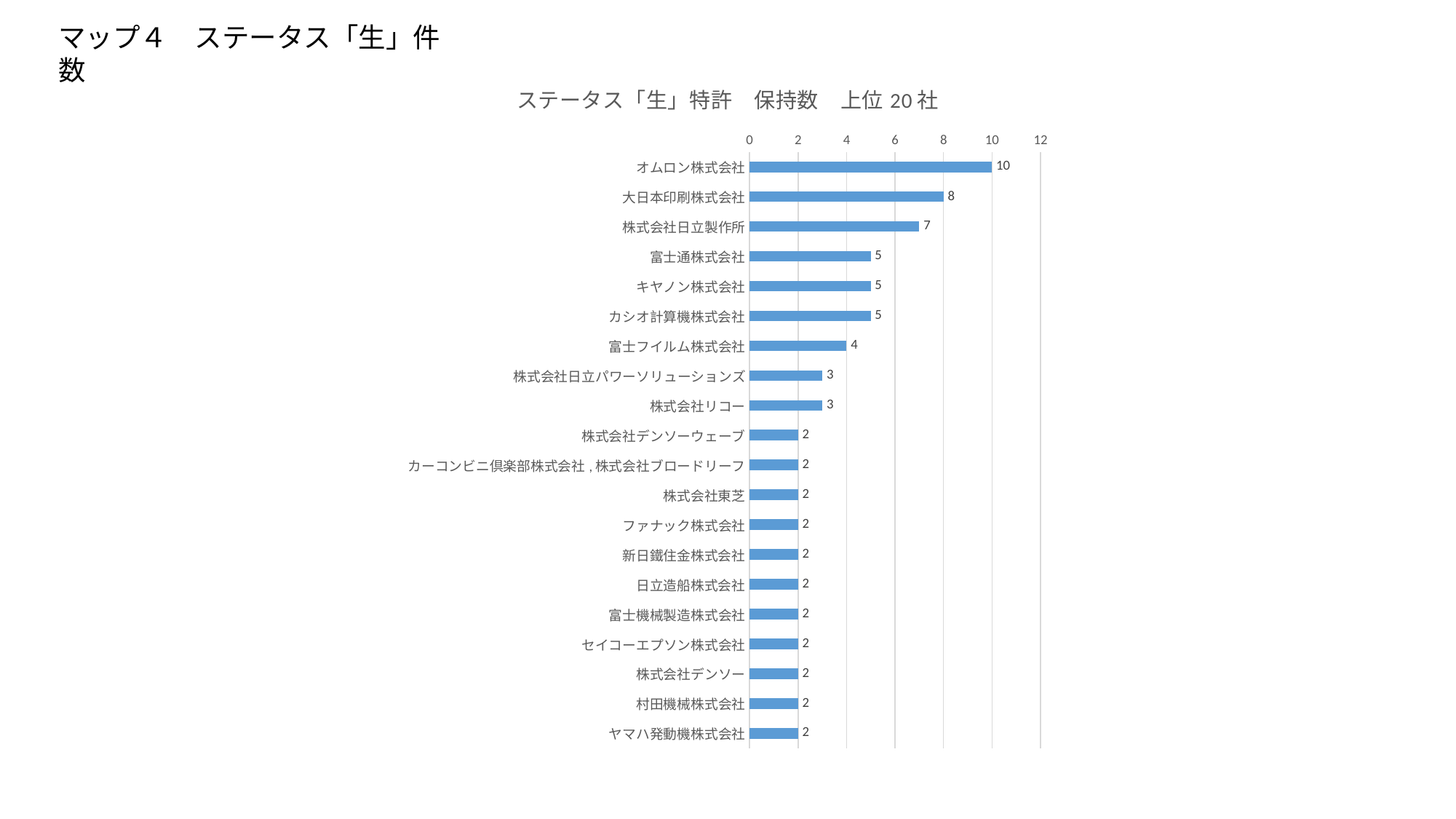
What is the value for 株式会社リコー? 3 Is the value for 大日本印刷株式会社 greater or less than 6? greater What is the title of the chart? ステータス「生」特許 保持数 上位 20 社 What is the value for オムロン株式会社? 10 Which company has the highest value? オムロン株式会社 What is the value for 株式会社日立製作所? 7 What is the difference between the values for オムロン株式会社 and 大日本印刷株式会社? 2 How many companies are shown in the chart? 20 What is the difference between the values for 株式会社日立製作所 and 富士通株式会社? 2 What kind of chart is shown on the slide? bar chart Which is larger, the value for 大日本印刷株式会社 or the value for キヤノン株式会社? 大日本印刷株式会社 What is the value for 富士フイルム株式会社? 4